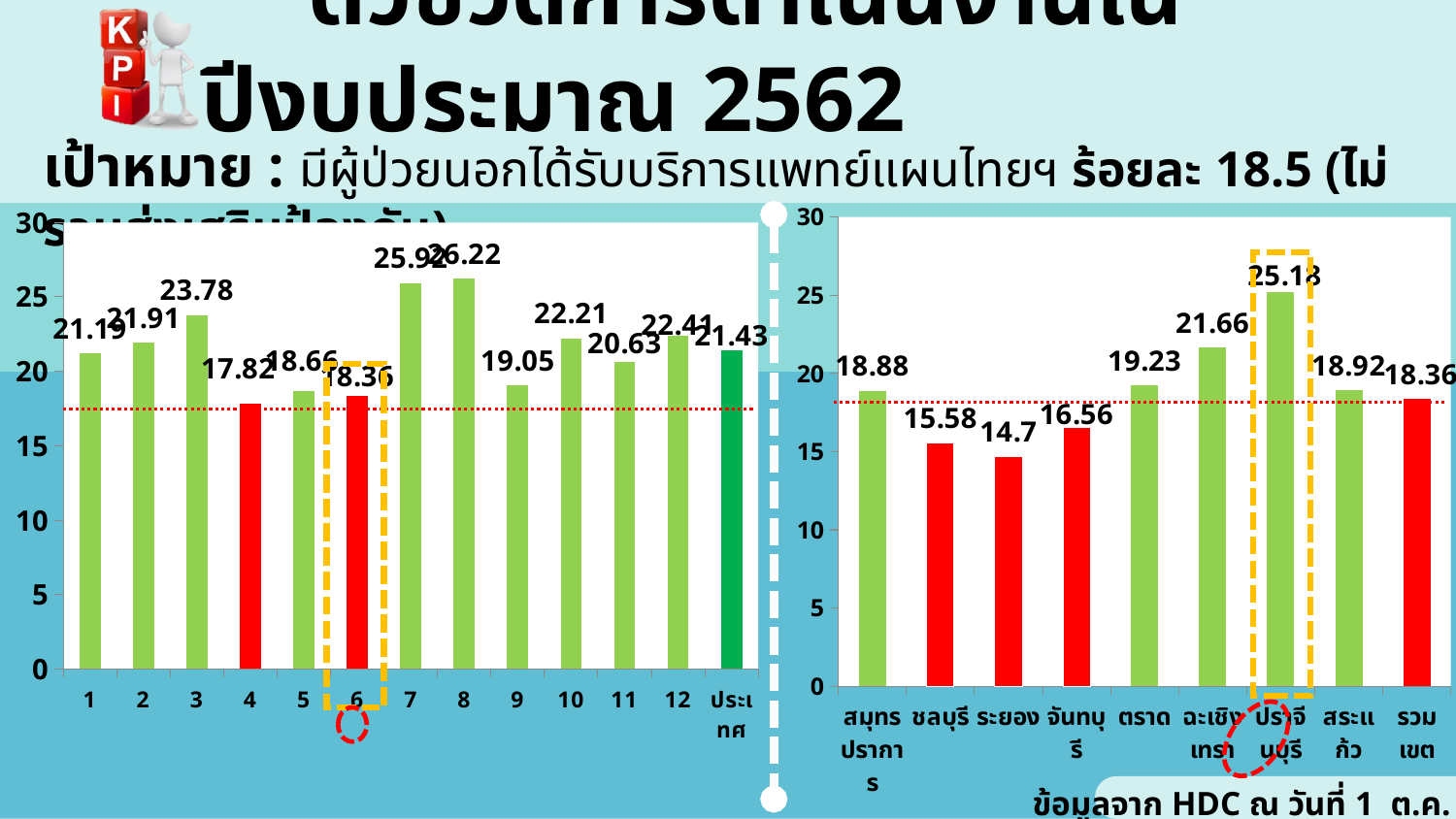
In the right chart, what is the value for รวมเขต? 18.36 In the right chart, what is the value for ระยอง? 14.7 In the right chart, which is larger, ตราด or จันทบุรี? ตราด In the right chart, what is the difference between ปราจีนบุรี and ชลบุรี? 9.6 In the right chart, which province has the lowest value? ระยอง In the right chart, which province has the highest value? ปราจีนบุรี In the left chart, what is the value for ประเทศ? 21.43 In the left chart, which category has the lowest value? 4 What type of chart is shown on the left? bar chart In the right chart, how many bars are plotted? 9 In the left chart, what is the value for category 8? 26.22 In the right chart, what is the value for ปราจีนบุรี? 25.18